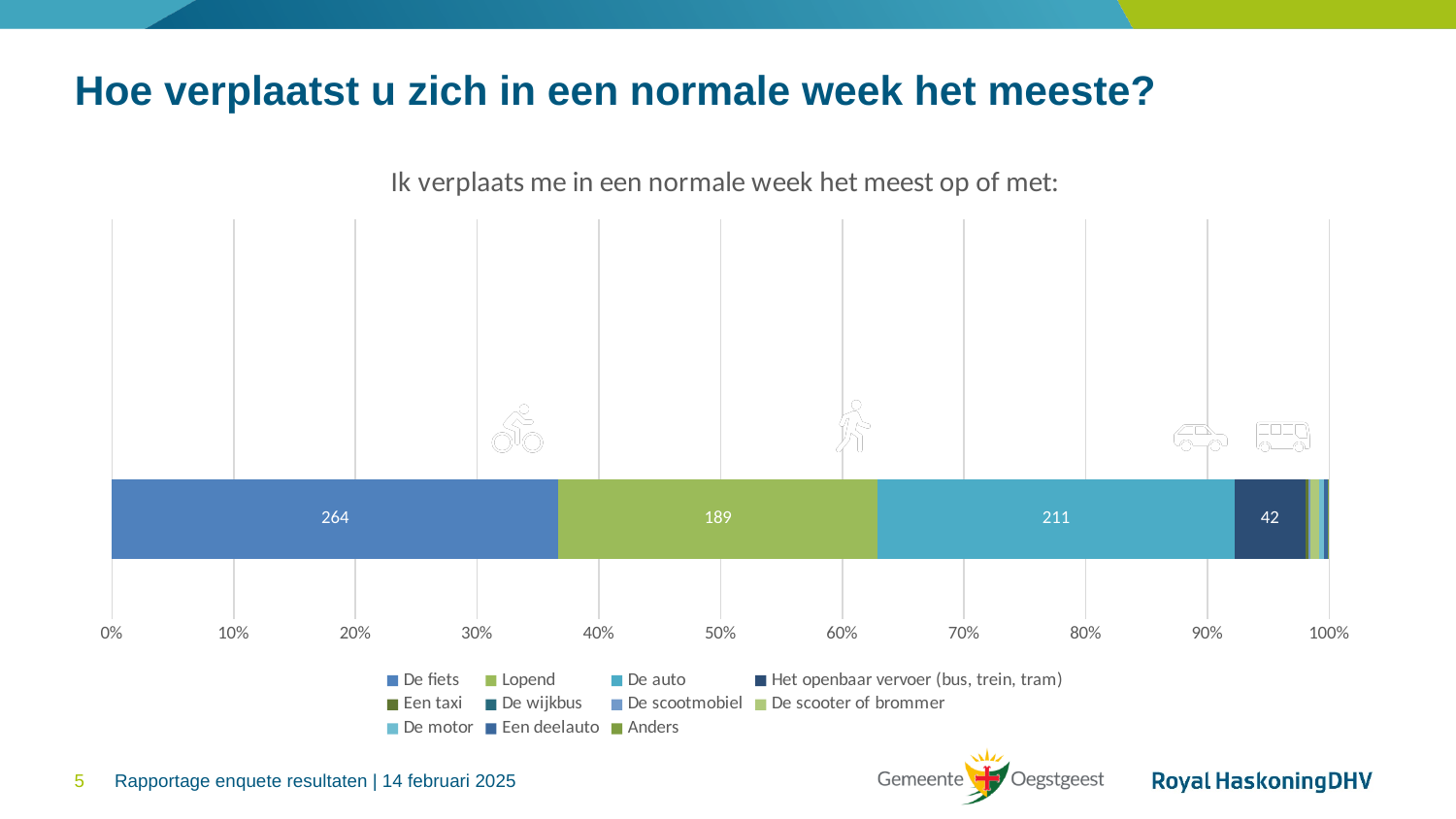
How many series does the legend list? 11 What is the title of the chart? Ik verplaats me in een normale week het meest op of met: What is the value shown for Lopend? 189 What is the difference between the values for De auto and Lopend? 22 What is the value shown for De auto? 211 What is the difference between the values for De fiets and Lopend? 75 Which is larger, the value for De auto or the value for Lopend? De auto Which labelled category has the highest value? De fiets What is the value shown for De fiets? 264 What is the value shown for Het openbaar vervoer (bus, trein, tram)? 42 Which labelled category has the lowest value? Het openbaar vervoer (bus, trein, tram) What kind of chart is shown on the slide? Stacked bar chart